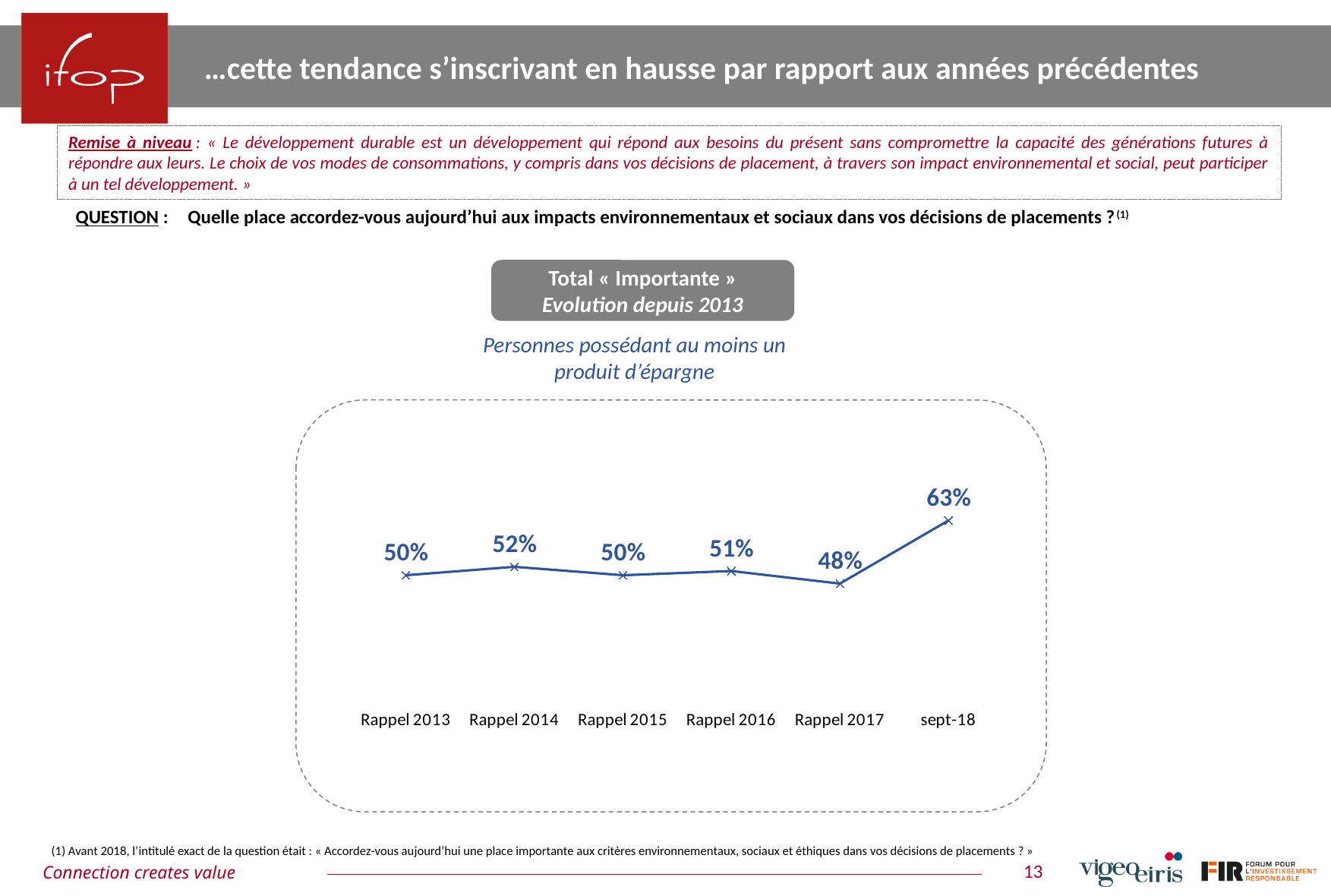
How many data points are plotted on the chart? 6 What is the value for Rappel 2013? 50% What is the subtitle shown above the chart describing the population? Personnes possédant au moins un produit d'épargne What is the difference between the values for sept-18 and Rappel 2017? 15% What is the difference between the values for Rappel 2014 and Rappel 2013? 2% Which point has the lowest value? Rappel 2017 What is the value for sept-18? 63% What kind of chart is shown on the slide? Line chart Which is larger, the value for Rappel 2016 or the value for Rappel 2017? Rappel 2016 Which point has the highest value? sept-18 What is the value for Rappel 2014? 52% What is the value for Rappel 2017? 48%